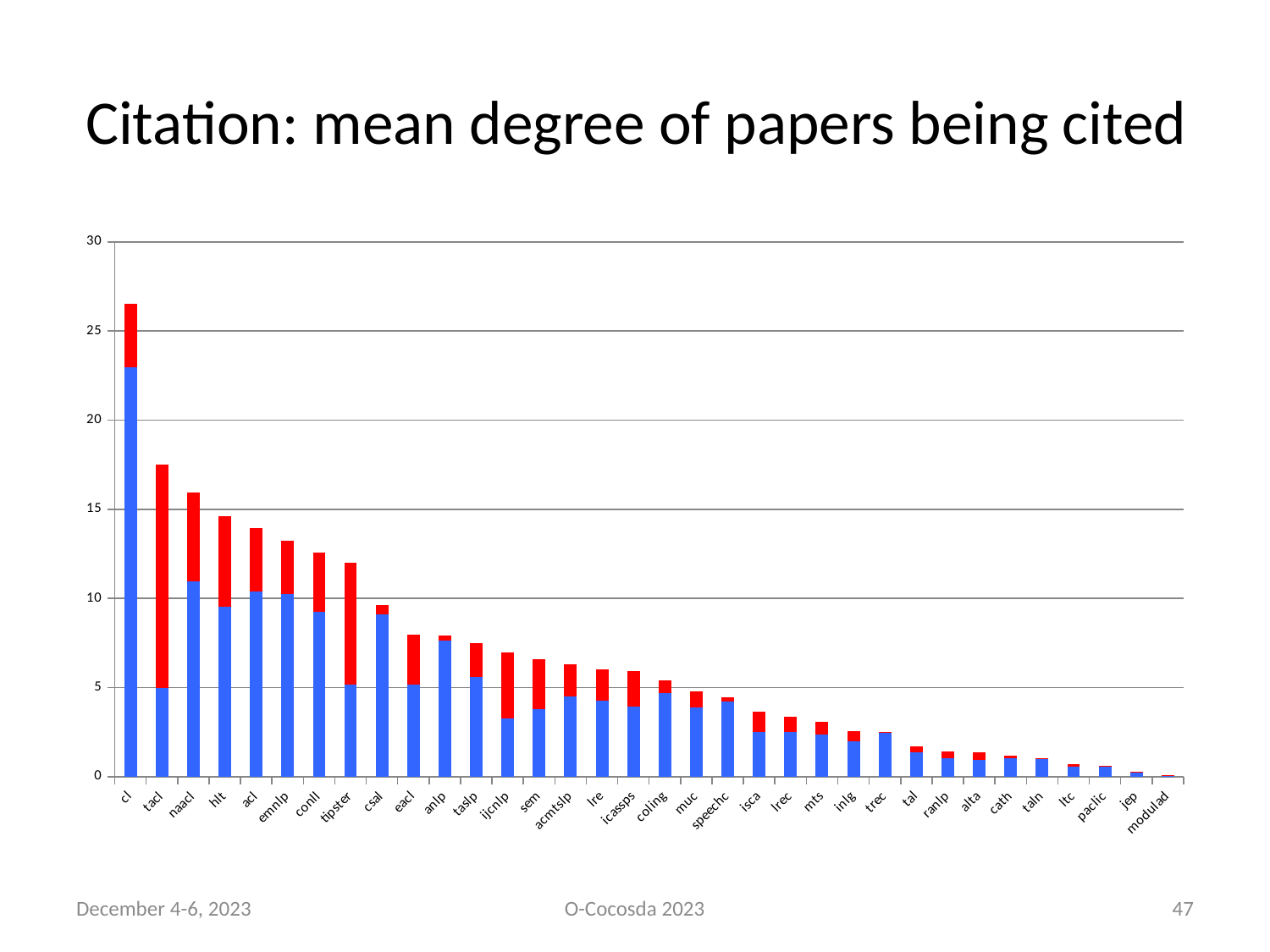
What is the title of the slide? Citation: mean degree of papers being cited Which category has the lowest total bar? modulad How many categories are shown on the x axis? 34 Which category has the highest total bar? cl Is the total value for tipster greater or less than 10? greater What kind of chart is shown on the slide? bar chart Is the total value for trec greater or less than 5? less Is the total value for eacl greater or less than 10? less Do the total bar values generally rise or fall from left to right along the x axis? fall Which has a larger total bar, cl or tacl? cl